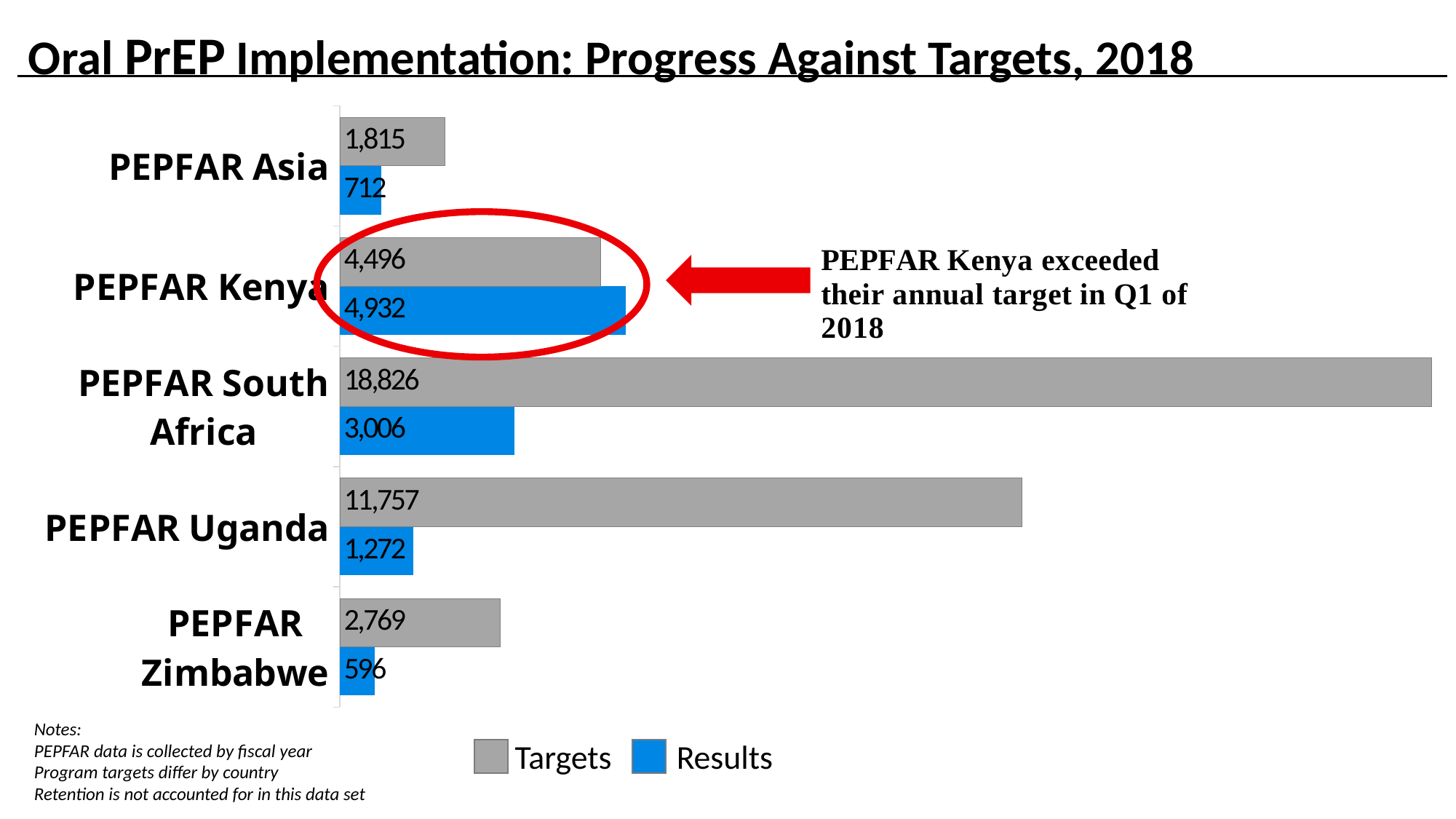
Which is larger for PEPFAR Kenya, the Targets value or the Results value? Results What kind of chart is shown on the slide? Bar chart What is the difference between the Targets and Results values for PEPFAR Uganda? 10,485 How many categories are shown on the chart? 5 How many series does the legend list? 2 What is the Targets value for PEPFAR South Africa? 18,826 Which category has the lowest Results value? PEPFAR Zimbabwe What colour are the Results bars? Blue Which category has the highest Targets value? PEPFAR South Africa What is the title of the slide? Oral PrEP Implementation: Progress Against Targets, 2018 What is the Results value for PEPFAR Zimbabwe? 596 What is the Results value for PEPFAR Kenya? 4,932